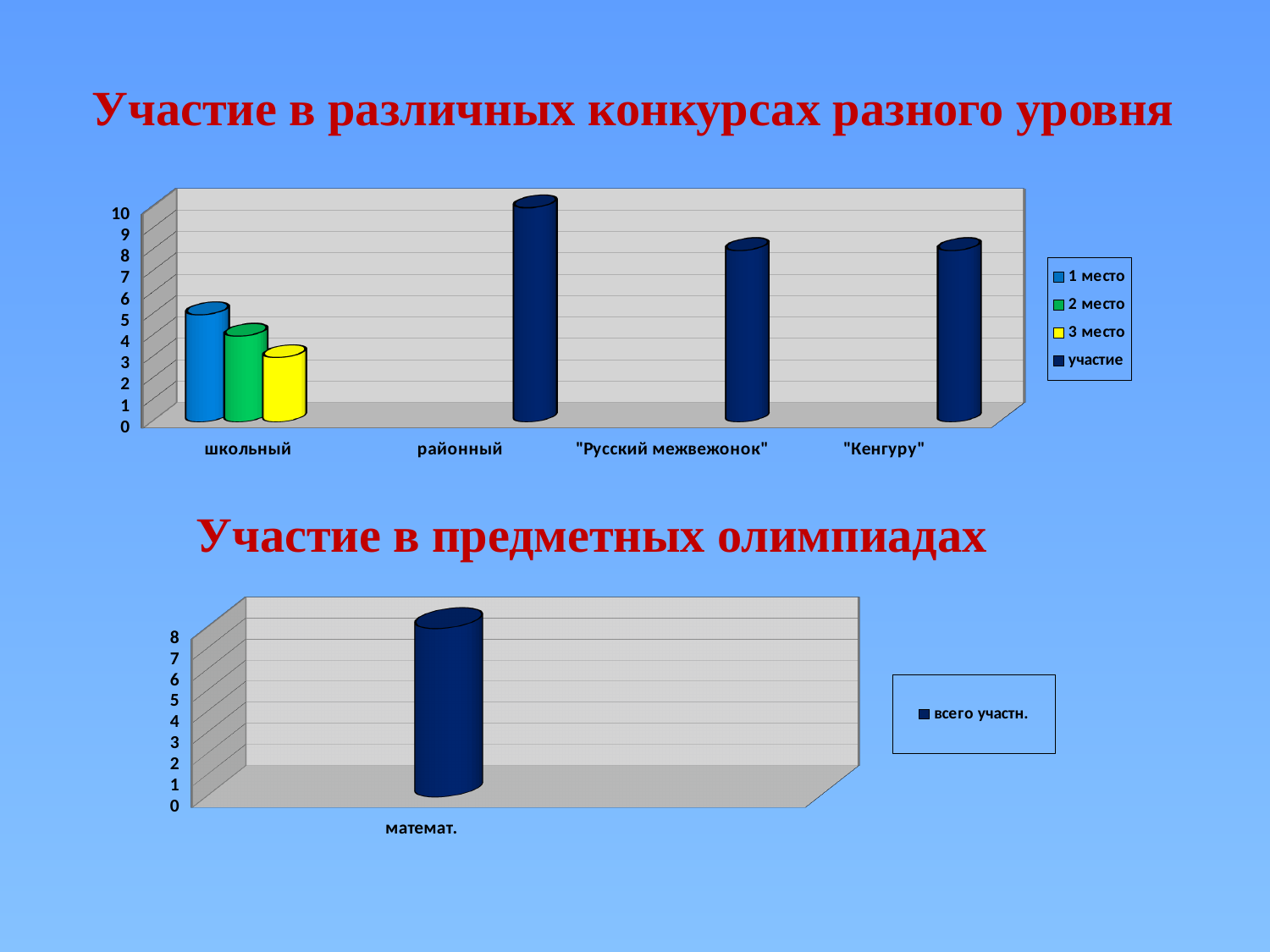
On the chart titled "Участие в различных конкурсах разного уровня", is the value for районный greater or less than 8? greater On the chart titled "Участие в различных конкурсах разного уровня", is the 1 место value for школьный greater or less than 4? greater On the chart titled "Участие в различных конкурсах разного уровня", how many categories are shown on the x axis? 4 On the chart titled "Участие в различных конкурсах разного уровня", for школьный, which is larger: 1 место or 3 место? 1 место On the chart titled "Участие в различных конкурсах разного уровня", what kind of chart is shown? bar chart On the chart titled "Участие в различных конкурсах разного уровня", is the 3 место value for школьный greater or less than 5? less On the chart titled "Участие в различных конкурсах разного уровня", which is larger: the bar for районный or the bar for "Русский межвежонок"? районный On the chart titled "Участие в различных конкурсах разного уровня", which category has the tallest bar? районный On the chart titled "Участие в предметных олимпиадах", how many categories are shown on the x axis? 1 On the chart titled "Участие в предметных олимпиадах", what series name does the legend show? всего участн. On the chart titled "Участие в различных конкурсах разного уровня", how many series does the legend list? 4